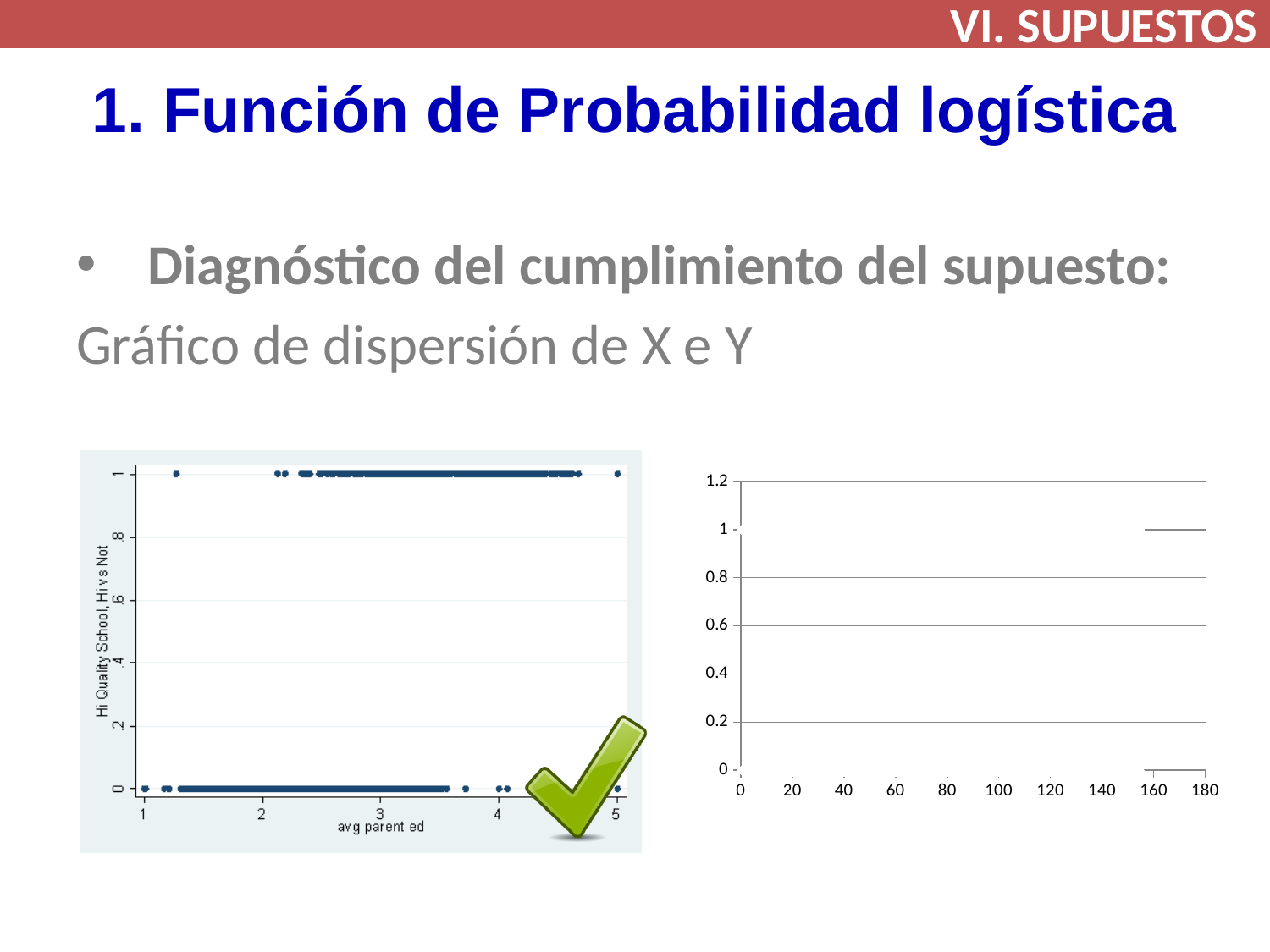
On the left chart, what is the label of the x axis? avg parent ed On the left chart, is the smallest avg parent ed value among the points plotted at y = 1 greater or less than 2? less On the right chart, what is the highest tick value shown on the x axis? 180 On the left chart, what is the label of the y axis? Hi Quality School, Hi vs Not On the left chart, what is the highest tick value shown on the x axis? 5 On the left chart, what are the two y values at which the points are plotted? 0 and 1 On the left chart, how many distinct y values do the plotted points take? 2 On the right chart, what is the interval between consecutive x-axis ticks? 20 What kind of chart is the left chart (the one with 'avg parent ed' on the x axis)? scatter chart On the right chart, what is the highest tick value shown on the y axis? 1.2